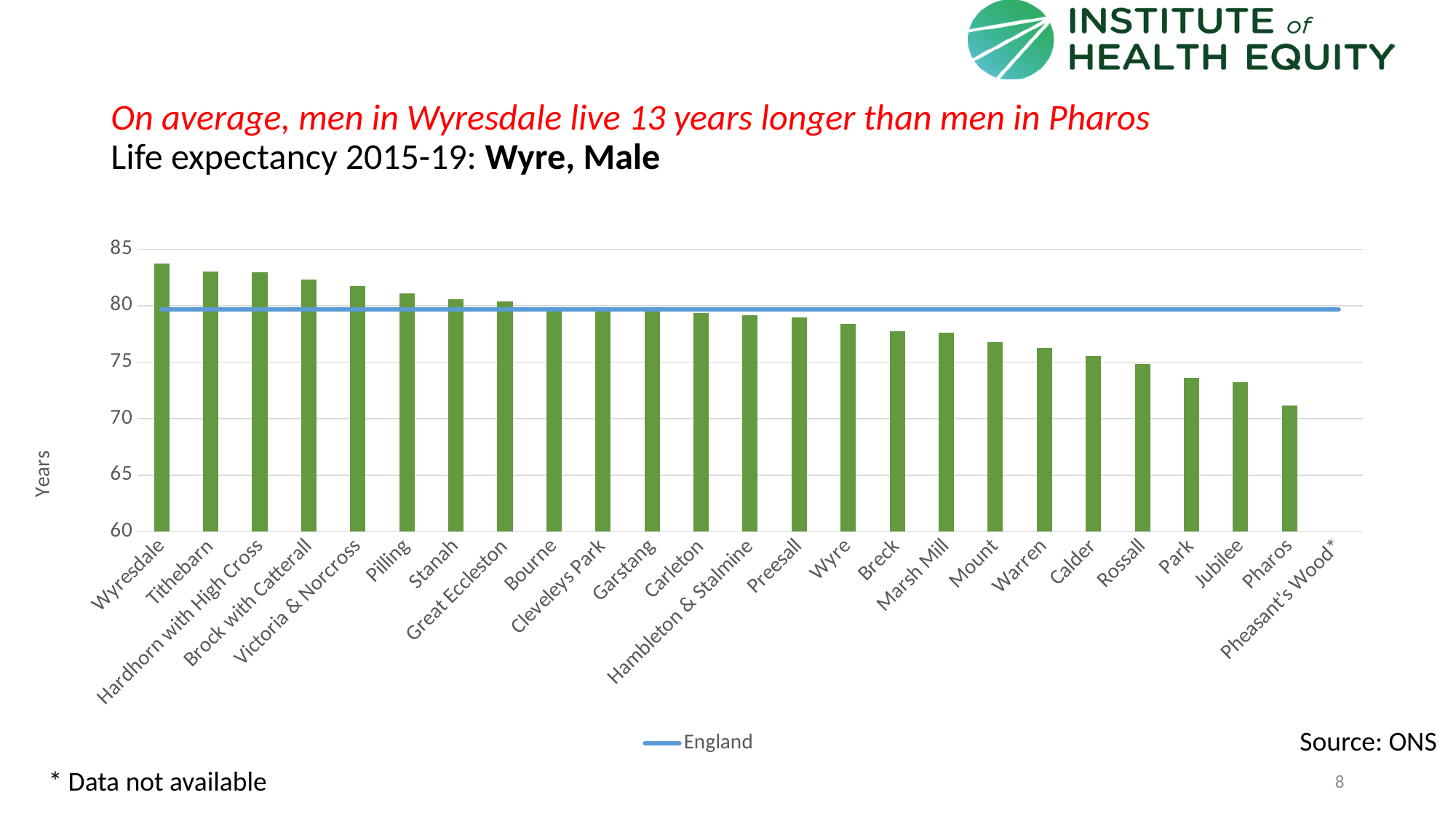
Which ward with a plotted bar has the lowest male life expectancy in the chart? Pharos Which ward has the highest male life expectancy in the chart? Wyresdale Which is larger, the value for Tithebarn or the value for Rossall? Tithebarn Is the value for Mount greater or less than 80? less Is the value for Wyresdale greater or less than 80? greater What kind of chart is shown on the slide? Combination bar and line chart Is the value for Pharos greater or less than 75? less How many ward categories are listed on the x axis, including the one marked as data not available? 25 What series does the legend list? England Do the bar values rise or fall moving from left to right along the x axis? Fall What is the label on the y axis? Years